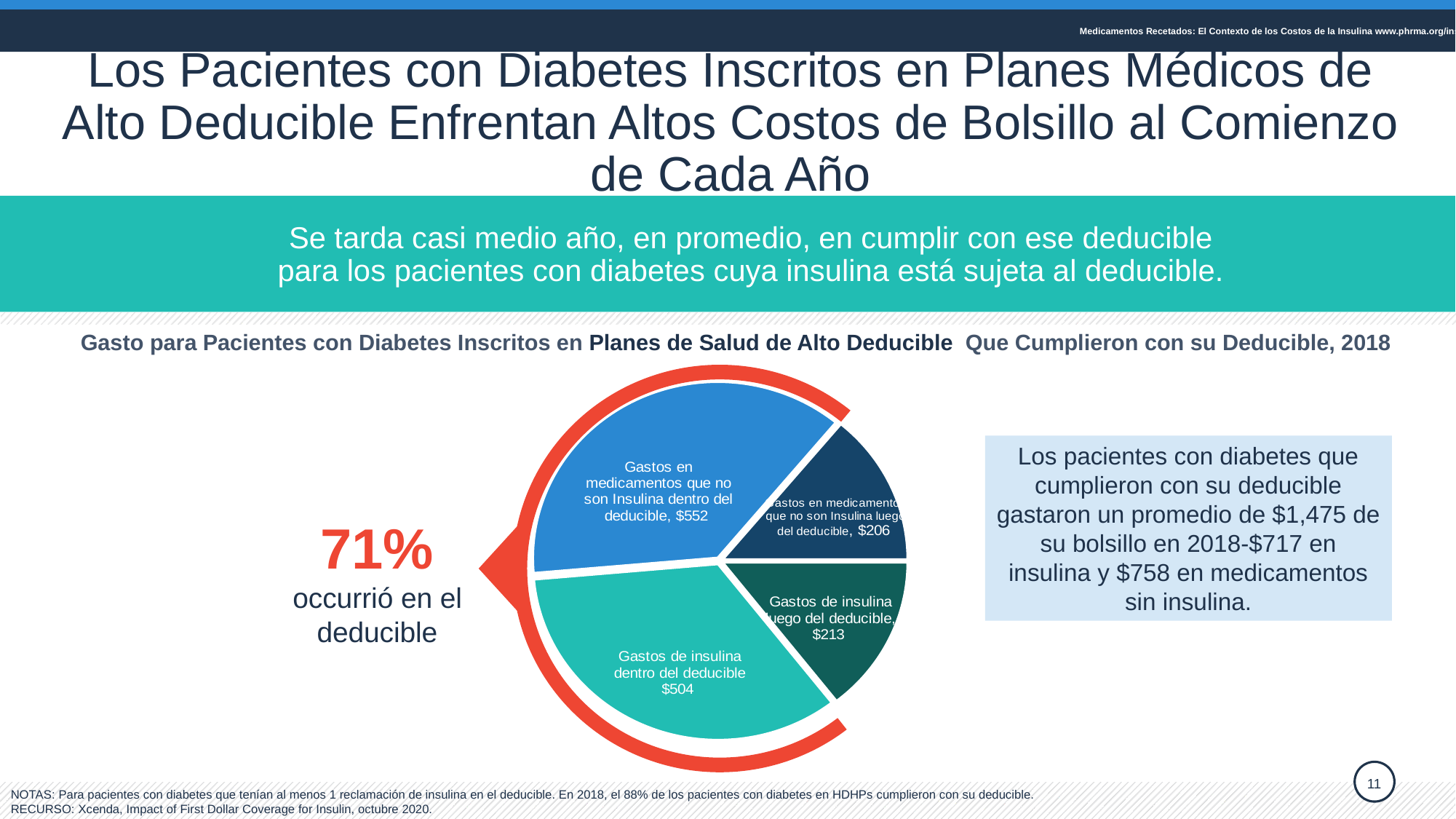
Which slice of the pie chart has the largest value? Gastos en medicamentos que no son Insulina dentro del deducible ($552) Which is larger: non-insulin spending within the deductible or insulin spending within the deductible? Non-insulin spending within the deductible ($552) What is the difference between non-insulin spending within the deductible ($552) and insulin spending within the deductible ($504)? $48 What is the value for insulin spending within the deductible (Gastos de insulina dentro del deducible)? $504 What is the total of all four slices in the pie chart? $1,475 What kind of chart is shown on the slide? Pie chart What is the difference between insulin spending after the deductible ($213) and non-insulin spending after the deductible ($206)? $7 According to the slide, what share of the spending occurred within the deductible? 71% What is the value for insulin spending after the deductible (Gastos de insulina luego del deducible)? $213 What is the value for non-insulin medication spending after the deductible (Gastos en medicamentos que no son Insulina luego del deducible)? $206 What is the value for non-insulin medication spending within the deductible (Gastos en medicamentos que no son Insulina dentro del deducible)? $552 How many slices does the pie chart have? 4